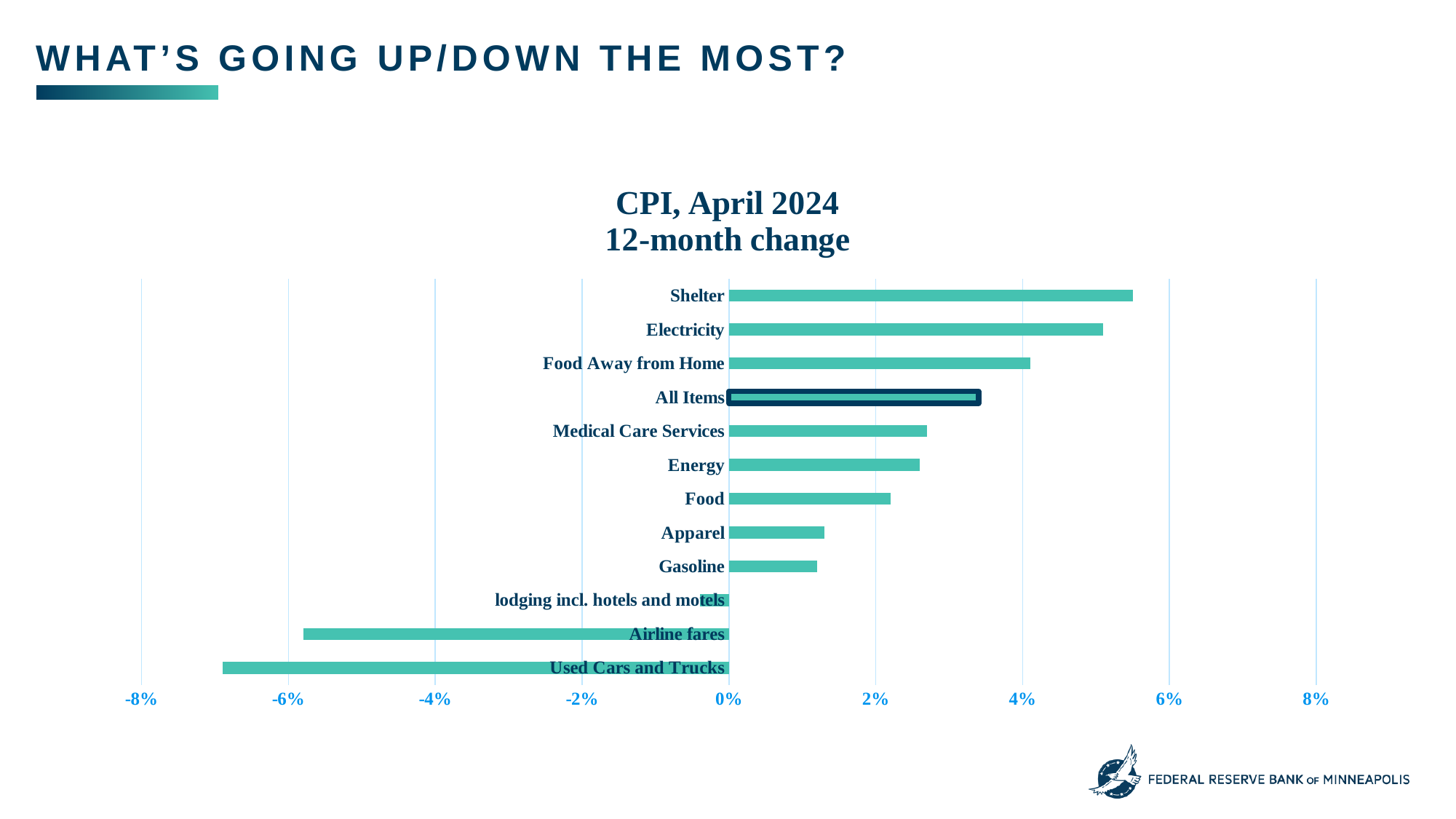
Is the value for All Items greater or less than 2%? greater Which has the larger 12-month change, Shelter or Food Away from Home? Shelter Is the value for Shelter greater or less than 4%? greater Which category has the highest 12-month change? Shelter Is the value for Apparel greater or less than 2%? less What is the title of the chart? CPI, April 2024 12-month change Which bar is drawn with a dark outline, distinguishing it from the others? All Items Which category has the lowest 12-month change? Used Cars and Trucks What kind of chart is shown on the slide? bar chart How many categories are plotted in the chart? 12